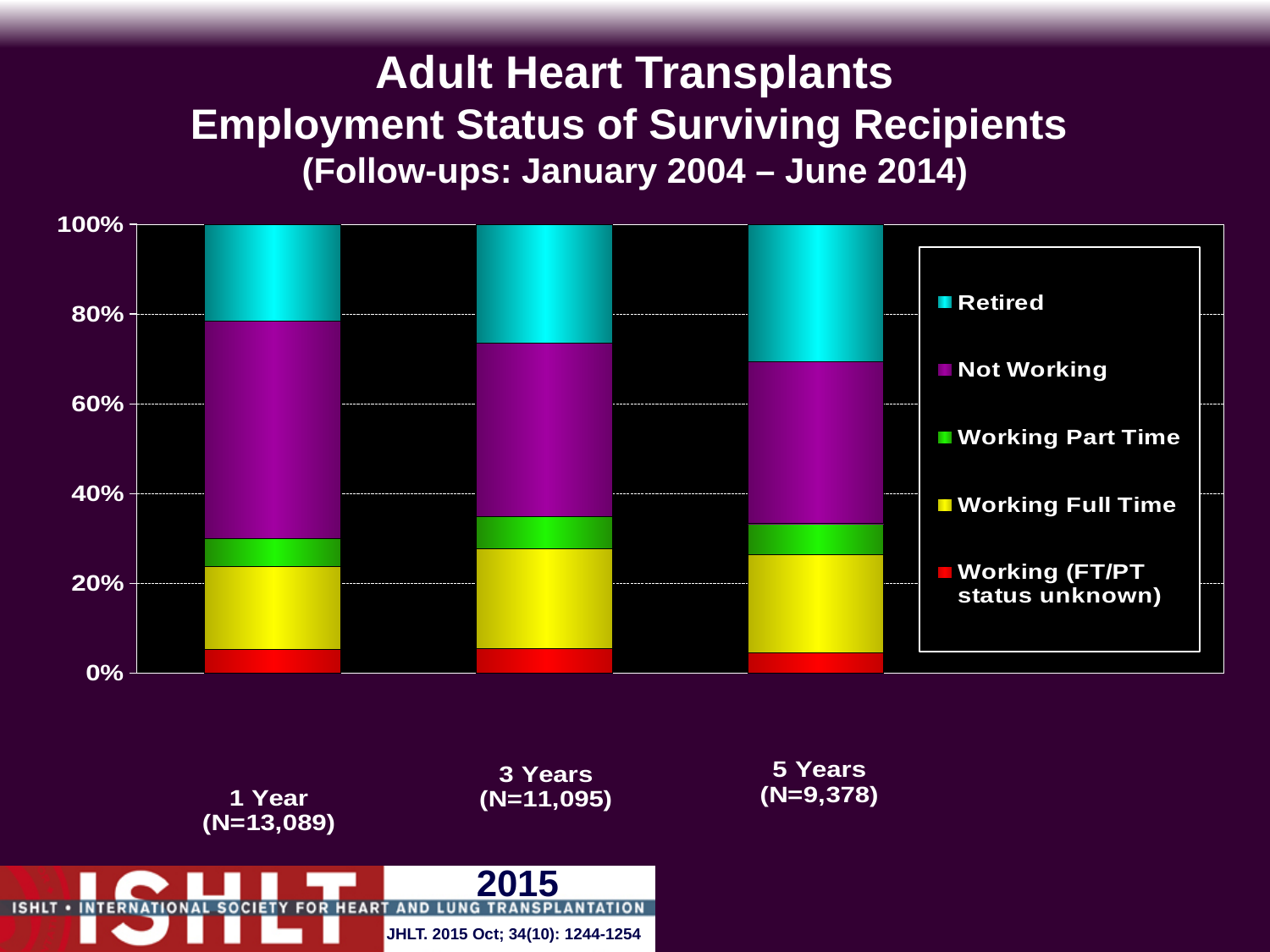
Is the Retired share at 5 Years larger or smaller than at 1 Year? Larger How many follow-up time points (bars) are shown in the chart? 3 What is the sample size (N) shown for the 5 Years follow-up? N=9,378 Is the Not Working share at 1 Year greater or less than 40%? greater Which follow-up time point has the largest Not Working share? 1 Year What is the sample size (N) shown for the 3 Years follow-up? N=11,095 Which employment status category is shown at the top of each stacked bar? Retired Does the Retired share rise or fall from 1 Year to 5 Years? Rise Is the Retired share at 1 Year greater or less than 40%? less Which follow-up time point has the largest Retired share? 5 Years How many series does the legend list? 5 What kind of chart is shown on the slide? Stacked bar chart